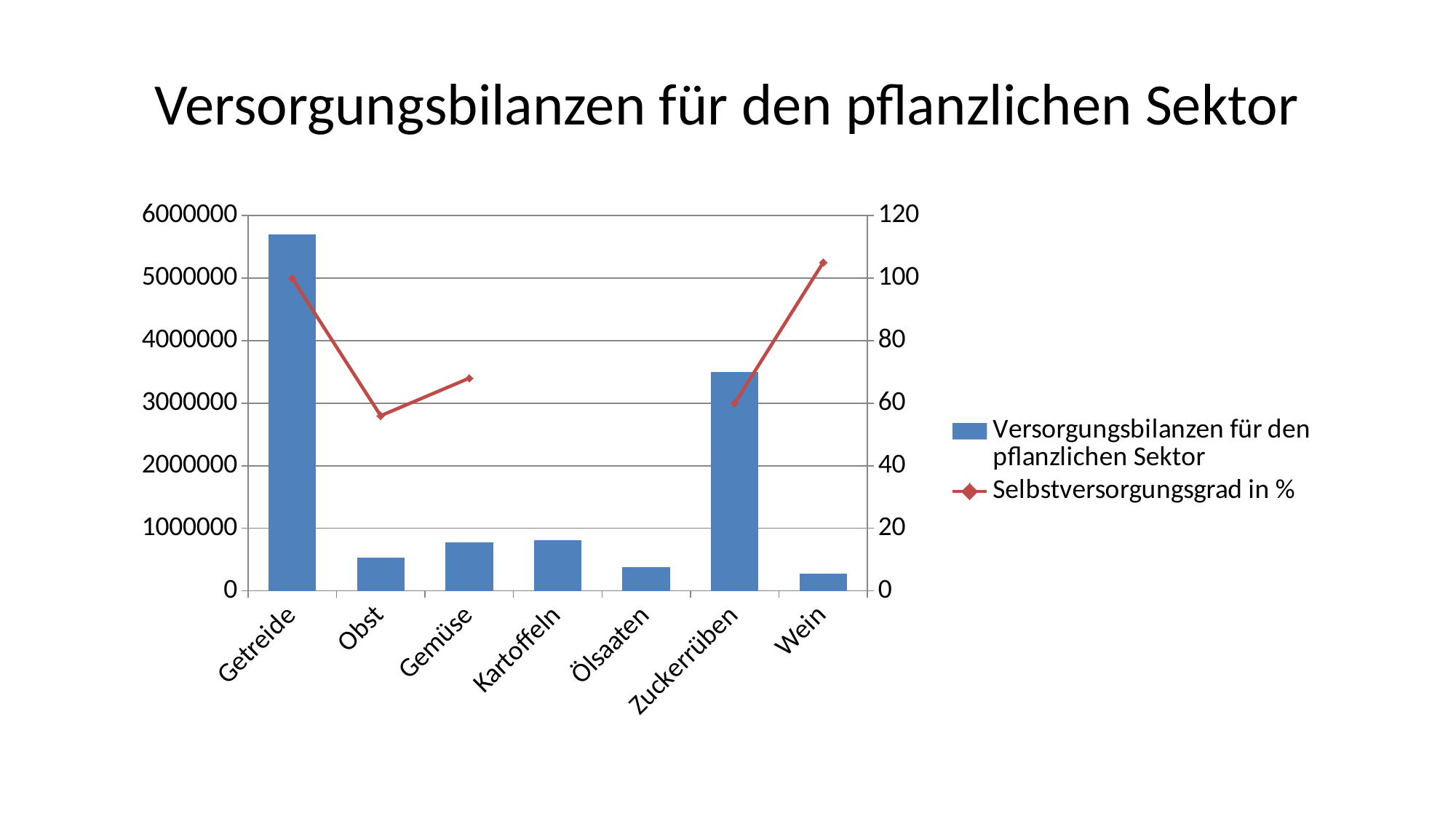
Which has the higher Selbstversorgungsgrad in %, Obst or Wein? Wein How many series does the chart legend list? 2 Which has the larger bar, Getreide or Zuckerrüben? Getreide What kind of chart is shown on the slide? Bar chart combined with a line Which category has the lowest bar for Versorgungsbilanzen für den pflanzlichen Sektor? Wein Is the Selbstversorgungsgrad in % for Wein greater or less than 100? greater How many categories are shown on the x axis of the chart? 7 Is the Selbstversorgungsgrad in % for Gemüse greater or less than 60? greater Is the bar value for Obst greater or less than 1000000? less Which category has the highest bar for Versorgungsbilanzen für den pflanzlichen Sektor? Getreide